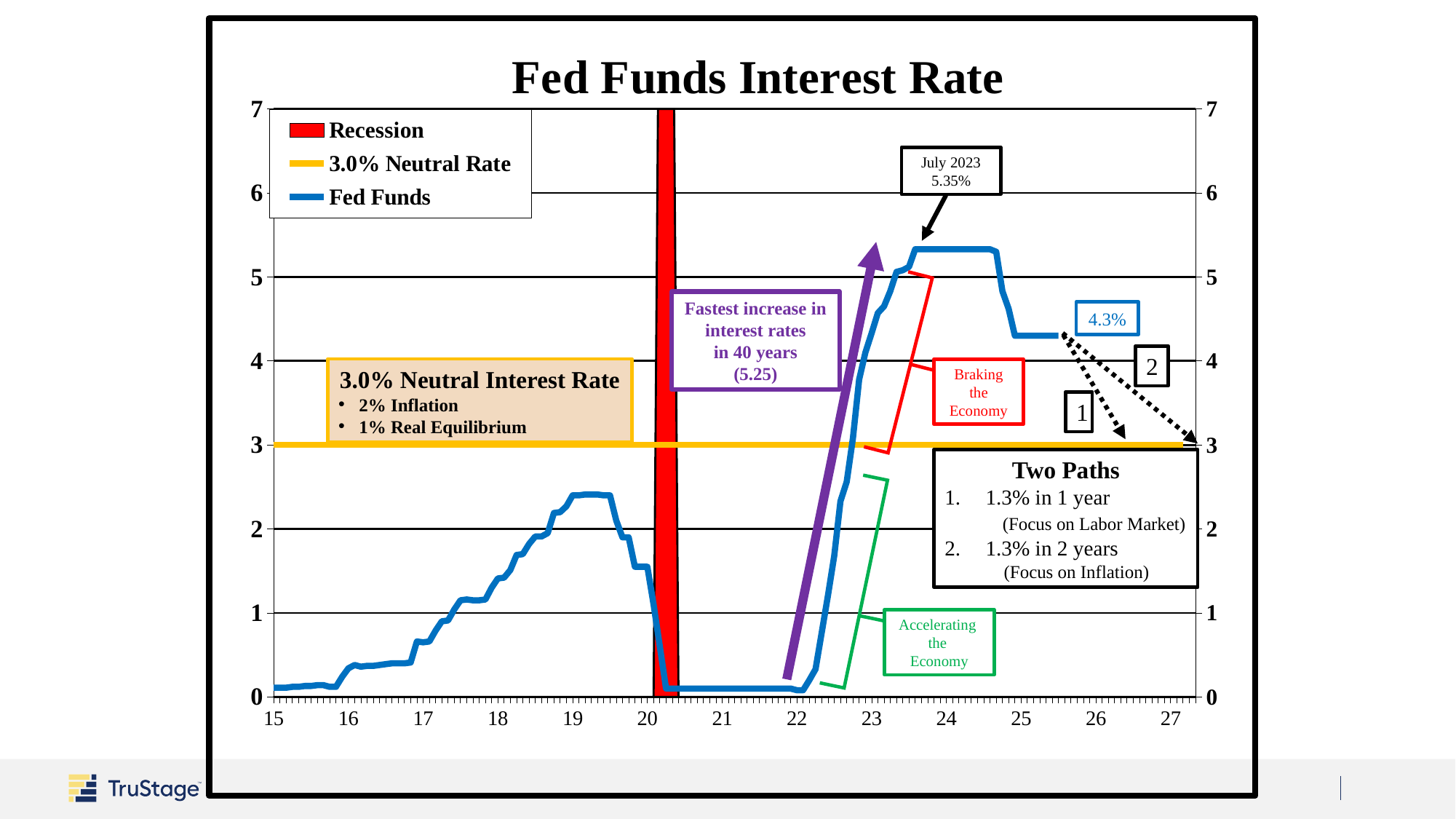
Is the Fed Funds rate in 2019 greater or less than 3? less How many entries does the chart's legend list? 3 What does the red shaded bar on the chart represent? Recession Is the Fed Funds rate in 2021 greater or less than 1? less Does the Fed Funds rate rise or fall between 2022 and 2023? rise What kind of chart is shown on the slide? line chart What is the difference between the July 2023 rate of 5.35% and the labelled 4.3% rate? 1.05% What Fed Funds rate is labelled for July 2023? 5.35% What is the neutral interest rate shown by the yellow line? 3.0% What is the title of the chart? Fed Funds Interest Rate What value is labelled at the end of the Fed Funds line around 2025? 4.3% Which is larger, the Fed Funds rate in 2024 or in 2019? 2024